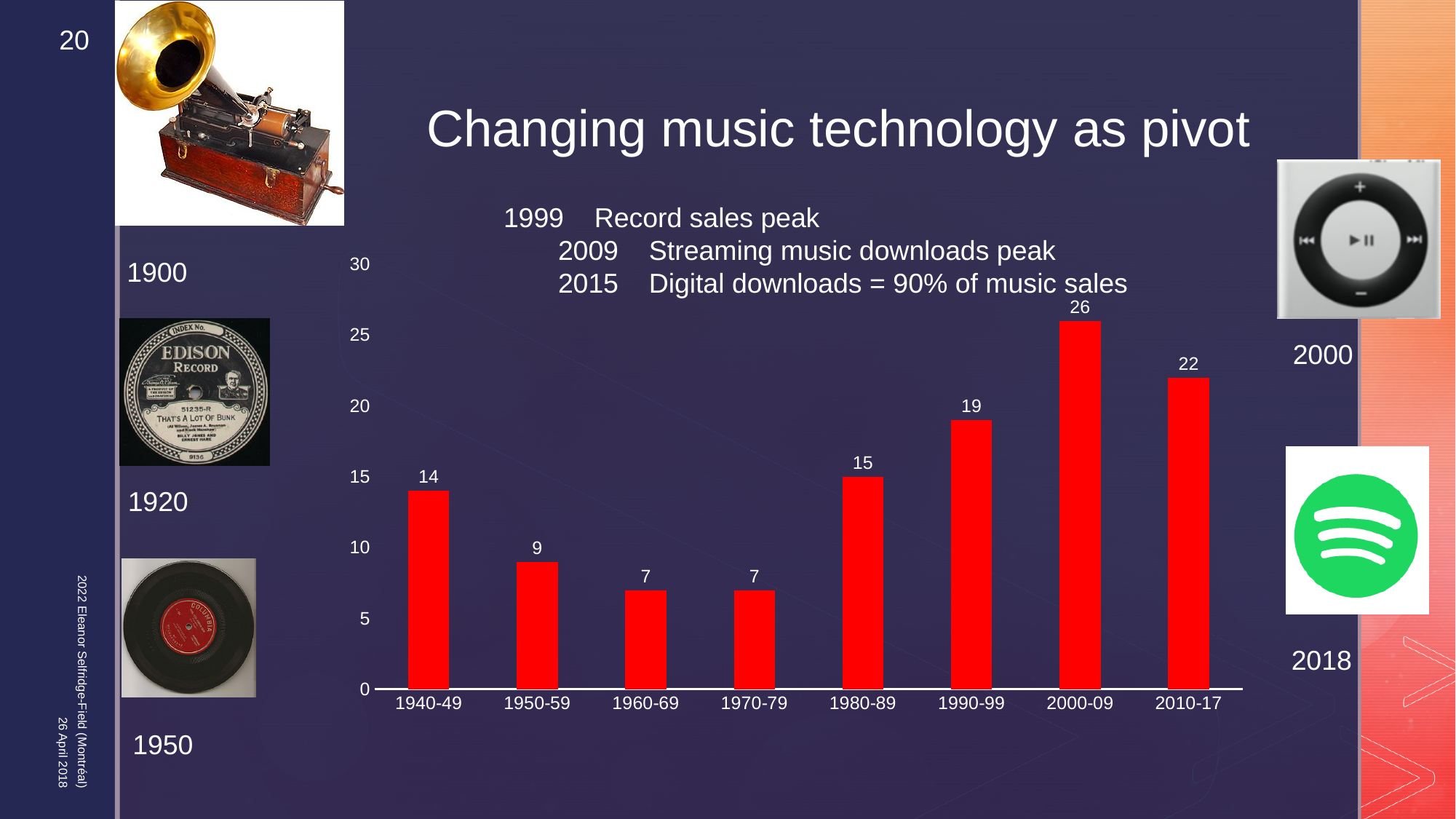
Is the value for 1990-99 greater or less than 15? greater What colour are the bars in the chart? red What is the value for 2010-17? 22 How many decade categories are shown on the x axis? 8 What kind of chart is shown on the slide? bar chart What is the difference between the values for 2000-09 and 2010-17? 4 Which is larger, the value for 1950-59 or the value for 1980-89? 1980-89 What is the value for 1940-49? 14 What is the difference between the values for 1940-49 and 1960-69? 7 Which decade has the highest value? 2000-09 Do the values rise or fall from 1970-79 to 2000-09? rise What is the value for 1990-99? 19